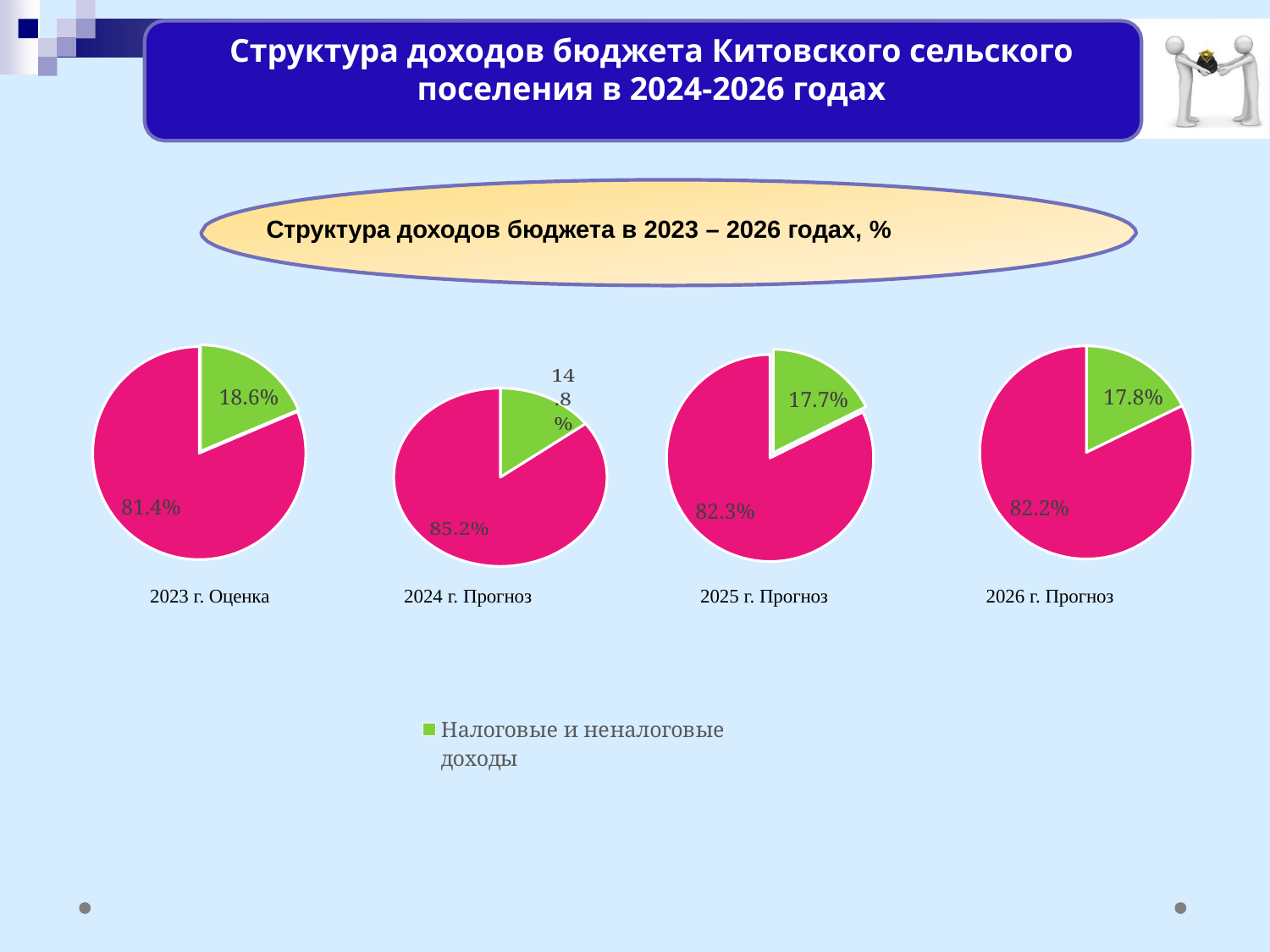
In the 2025 г. Прогноз pie chart, what share is shown for the pink slice? 82.3% In the 2026 г. Прогноз pie chart, what share is shown for Налоговые и неналоговые доходы? 17.8% Which of the four pie charts shows the largest share for Налоговые и неналоговые доходы? 2023 г. Оценка What kind of chart is used to show the budget revenue structure on this slide? Pie chart In the 2024 г. Прогноз pie chart, what share is shown for Налоговые и неналоговые доходы? 14.8% In the 2025 г. Прогноз pie chart, what share is shown for Налоговые и неналоговые доходы? 17.7% What is the difference between the pink slice and the green slice in the 2024 г. Прогноз pie chart? 70.4% In the 2023 г. Оценка pie chart, what share is shown for Налоговые и неналоговые доходы? 18.6% Which of the four pie charts shows the smallest share for Налоговые и неналоговые доходы? 2024 г. Прогноз In the 2023 г. Оценка pie chart, what share is shown for the pink slice? 81.4% In the 2024 г. Прогноз pie chart, what share is shown for the pink slice? 85.2% In the 2026 г. Прогноз pie chart, what share is shown for the pink slice? 82.2%